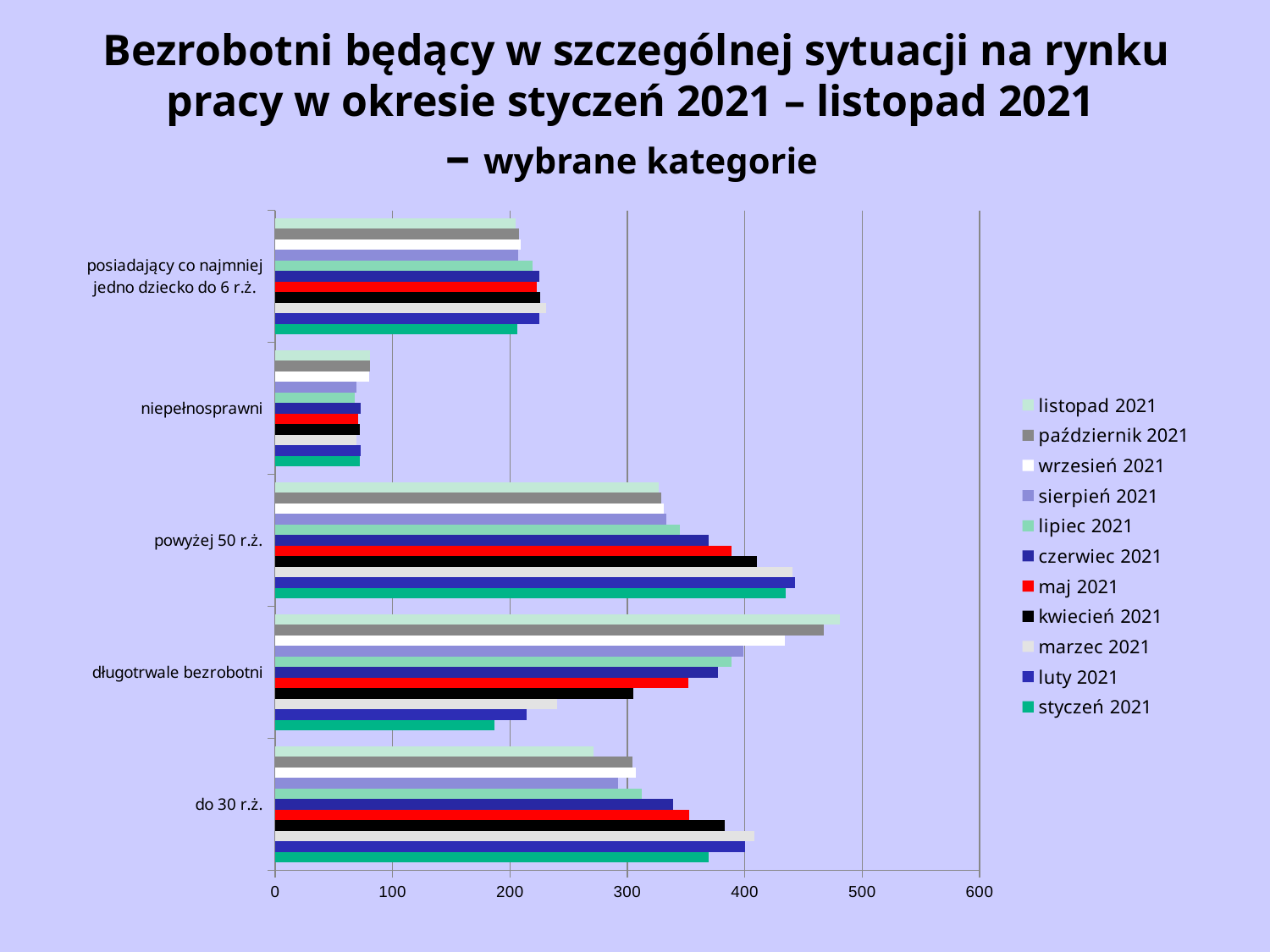
How many series does the legend list? 11 Which month has the lowest value for 'długotrwale bezrobotni'? styczeń 2021 Is the value for 'do 30 r.ż.' in listopad 2021 greater or less than 300? less Is the value for 'długotrwale bezrobotni' in listopad 2021 greater or less than 400? greater How many categories are shown on the vertical axis of the chart? 5 Which month has the highest value for 'długotrwale bezrobotni'? listopad 2021 Is the value for 'długotrwale bezrobotni' in styczeń 2021 greater or less than 200? less Did the value for 'długotrwale bezrobotni' rise or fall from styczeń 2021 to listopad 2021? rise For listopad 2021, which category has the larger value: 'niepełnosprawni' or 'długotrwale bezrobotni'? długotrwale bezrobotni What kind of chart is shown on the slide? bar chart